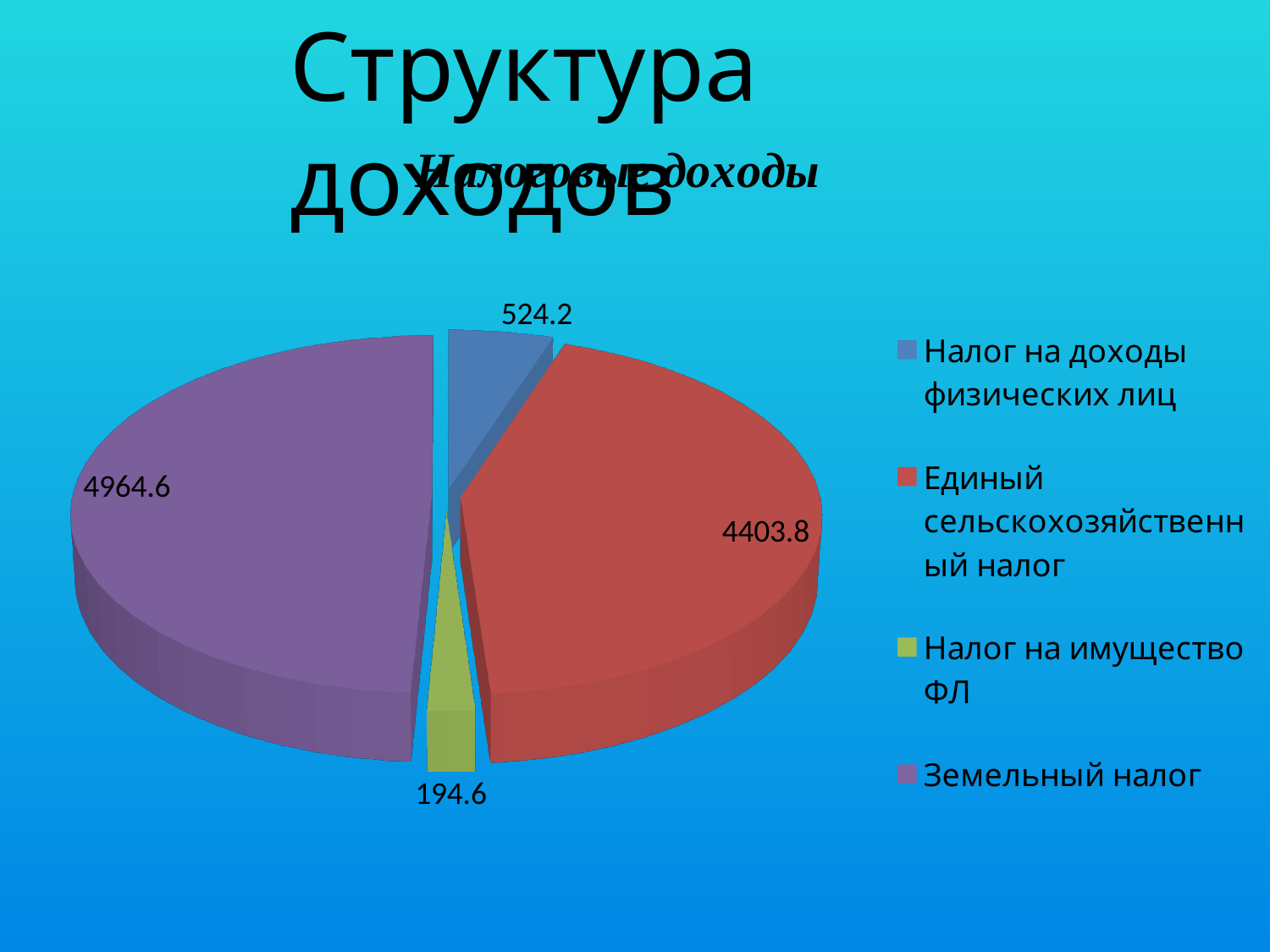
What is the value for Налог на доходы физических лиц? 524.2 What kind of chart is shown on the slide? Pie chart How many categories does the pie chart show? 4 What is the value for Единый сельскохозяйственный налог? 4403.8 What is the difference between Земельный налог and Единый сельскохозяйственный налог? 560.8 Which is larger, Налог на доходы физических лиц or Налог на имущество ФЛ? Налог на доходы физических лиц What is the difference between Налог на доходы физических лиц and Налог на имущество ФЛ? 329.6 Which category has the smallest slice? Налог на имущество ФЛ Which category has the largest slice? Земельный налог What is the value for Земельный налог? 4964.6 What is the value for Налог на имущество ФЛ? 194.6 What colour is the slice for Земельный налог? Purple